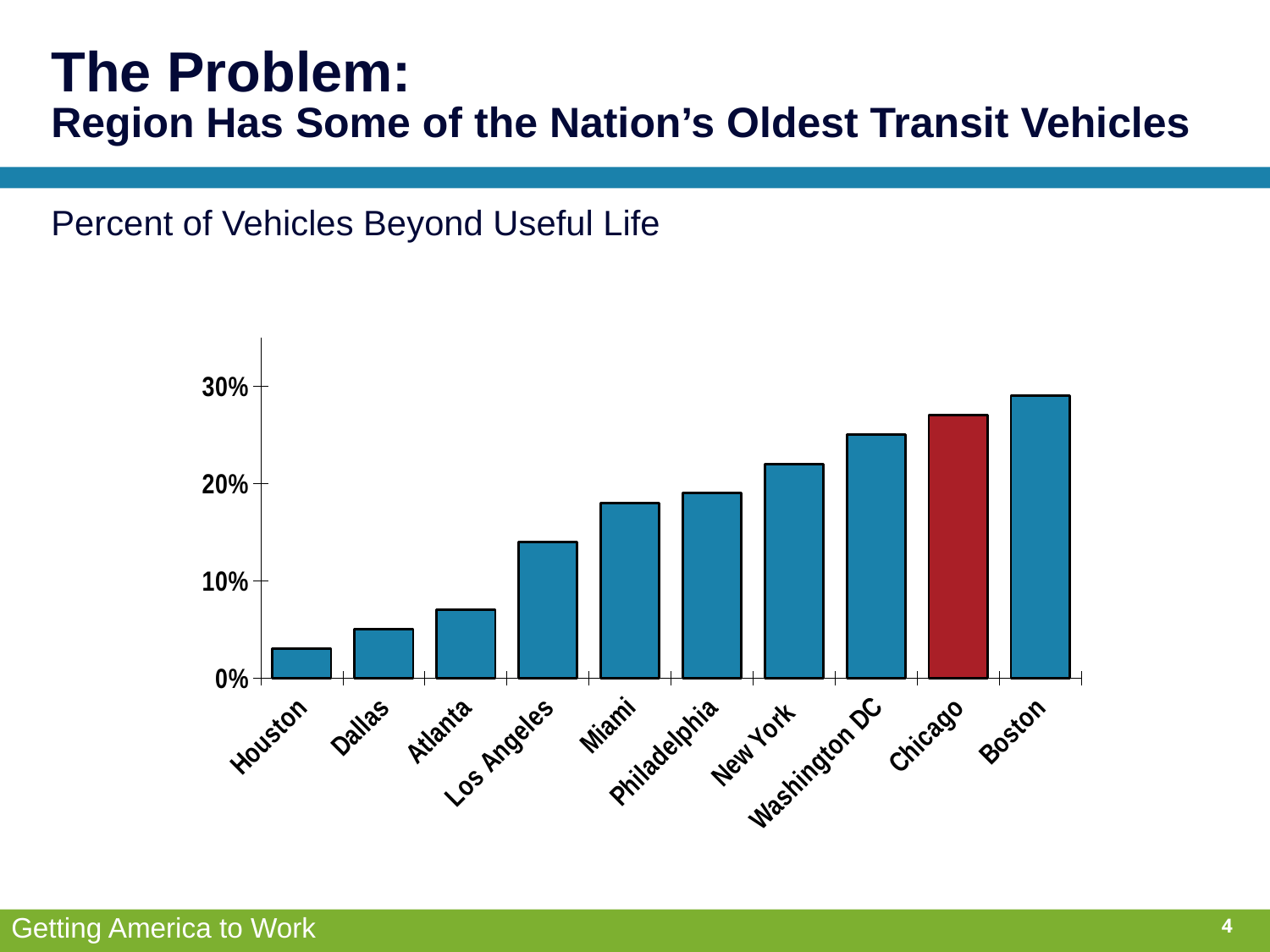
Is the value for Miami greater or less than 10%? greater Which city has the highest percent of vehicles beyond useful life? Boston Which has a higher percent of vehicles beyond useful life, Los Angeles or New York? New York Which city's bar is coloured red instead of blue? Chicago What kind of chart is shown on the slide? bar chart Is the value for Chicago greater or less than 20%? greater Is the value for Atlanta greater or less than 10%? less What does the chart measure, according to the text above it? Percent of Vehicles Beyond Useful Life Do the values rise or fall moving from Houston to Boston along the x axis? rise How many cities are shown on the chart? 10 Which city has the lowest percent of vehicles beyond useful life? Houston